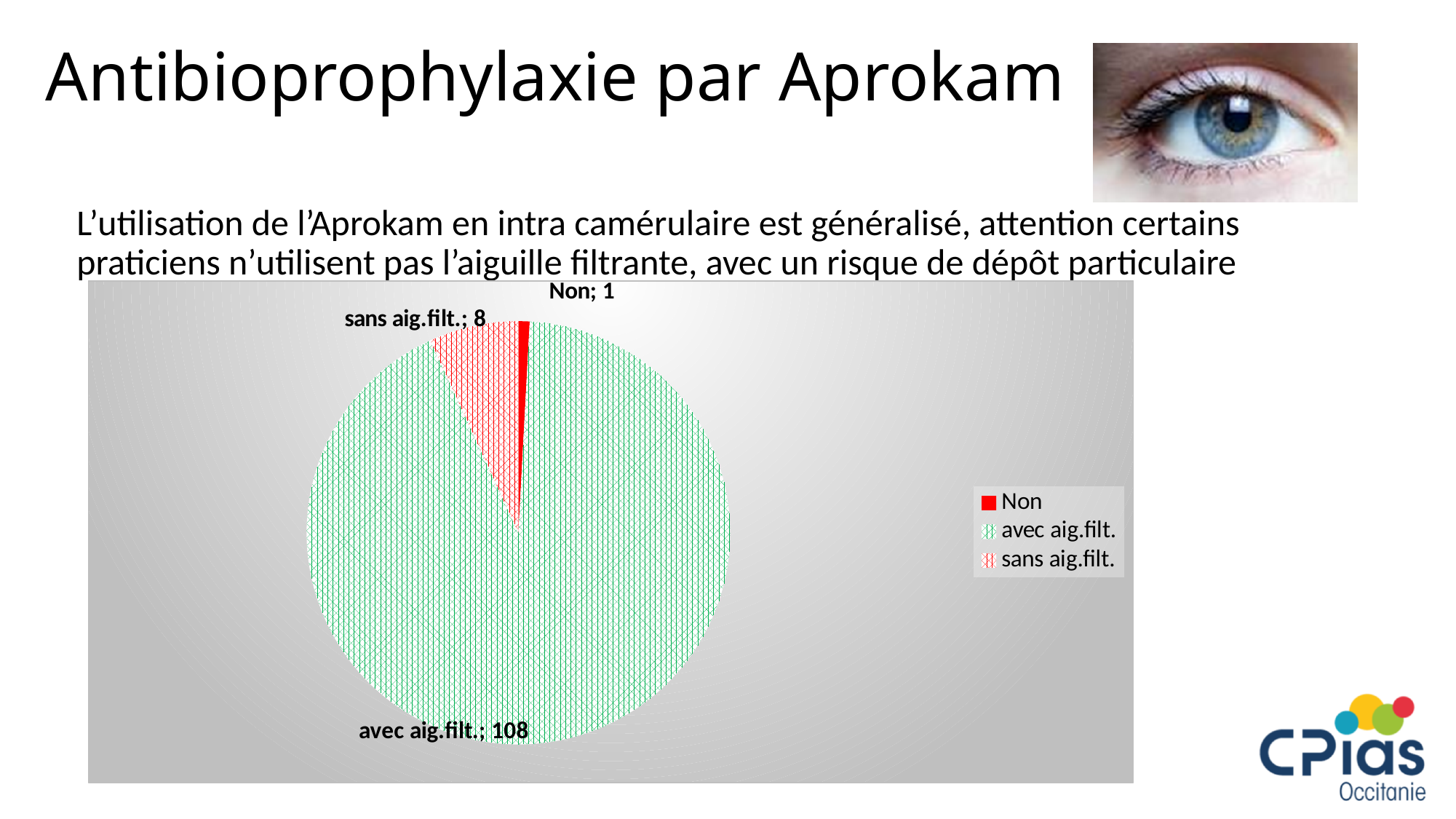
What is the total of all the values in the pie chart? 117 What kind of chart is shown on the slide? Pie chart What is the difference between the values for "sans aig.filt." and "Non"? 7 Which category has the smallest slice in the pie chart? Non What is the value for "sans aig.filt." in the pie chart? 8 How many categories does the pie chart have? 3 Which category has the largest slice in the pie chart? avec aig.filt. What colour is the "Non" slice in the pie chart? Red What is the value for "Non" in the pie chart? 1 What is the value for "avec aig.filt." in the pie chart? 108 What is the difference between the values for "avec aig.filt." and "sans aig.filt."? 100 Which is larger, the value for "sans aig.filt." or the value for "Non"? sans aig.filt.